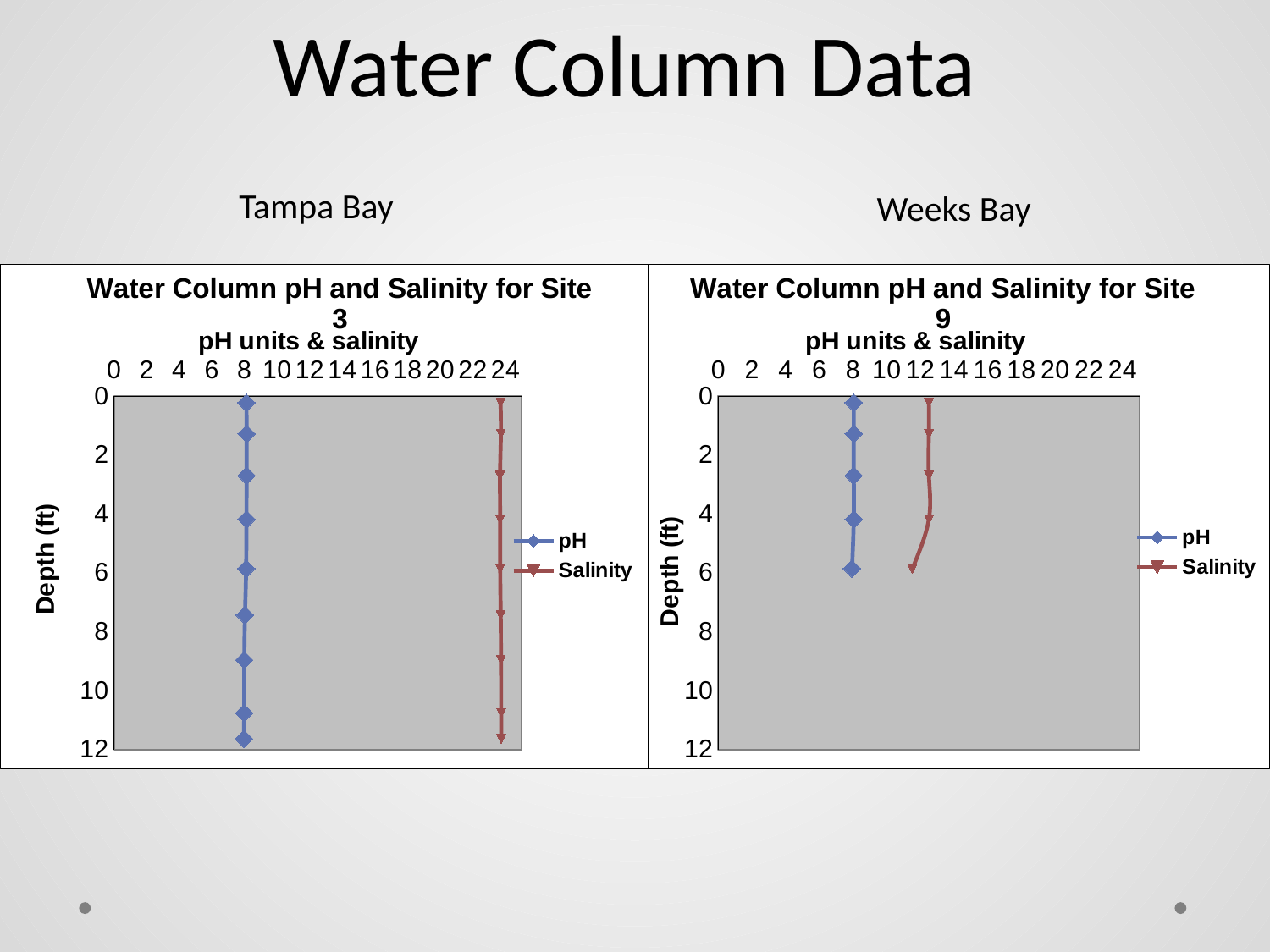
What is the vertical axis title on the Site 3 chart? Depth (ft) What kind of chart is the Site 9 chart? line chart On the Site 3 chart, is the pH value at depth 0 greater or less than 10? less On the Site 9 chart, is the Salinity value at depth 0 greater or less than 10? greater On the Site 9 chart, does the Salinity value increase or decrease as depth increases? decrease On the Site 3 chart, which series has the larger values, pH or Salinity? Salinity How many data points does the pH series have on the Site 3 chart? 9 How many data points does the pH series have on the Site 9 chart? 5 How many series does the legend list on the Site 3 chart? 2 On the Site 9 chart, which series has the smaller values, pH or Salinity? pH On the Site 9 chart, is the Salinity value at depth 0 greater or less than 16? less